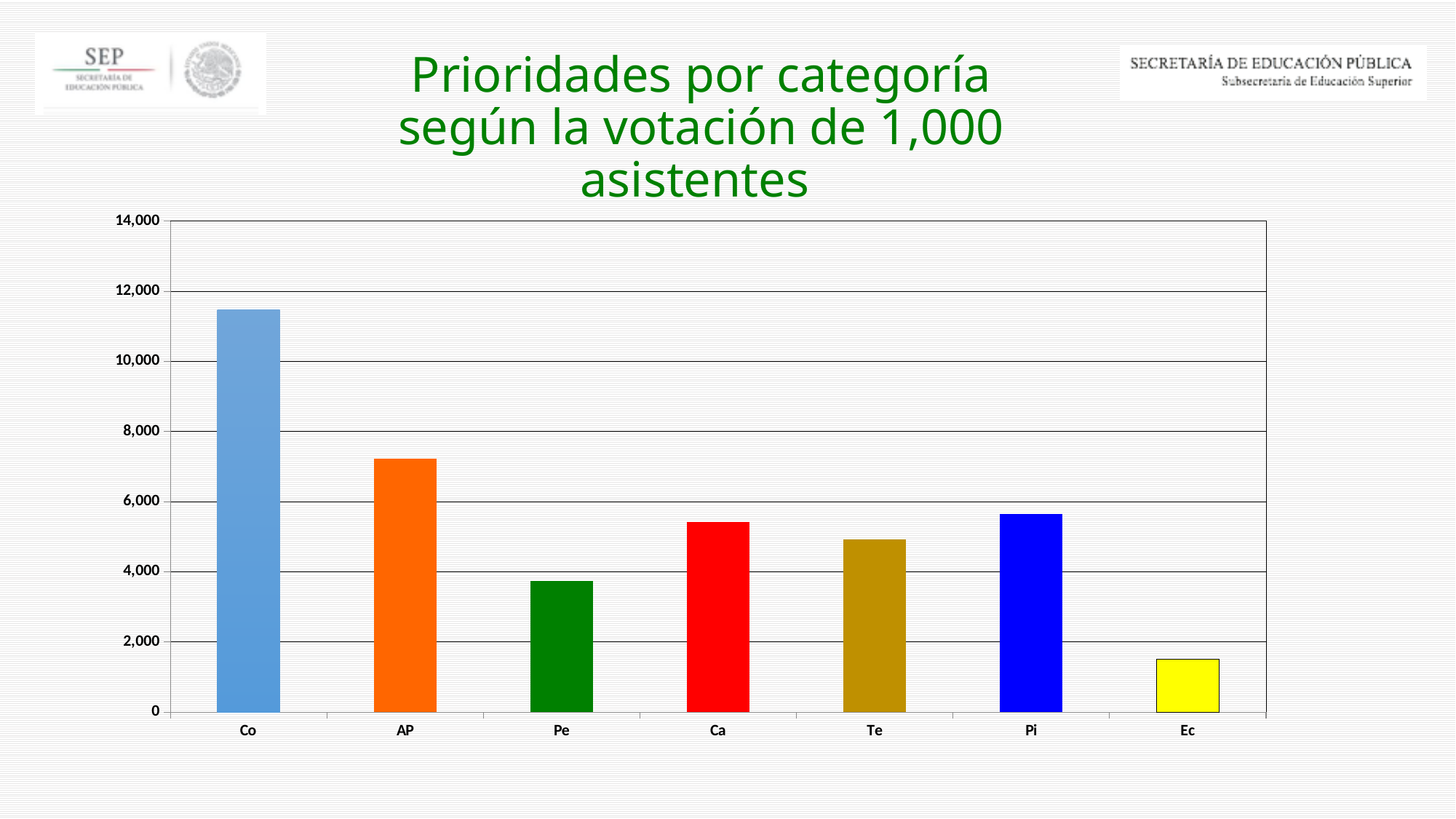
What is the title of the chart? Prioridades por categoría según la votación de 1,000 asistentes Which category has the highest value? Co Is the value for Te greater or less than 4,000? greater Is the value for AP greater or less than 8,000? less Which category has the lowest value? Ec Which is larger, the value for Co or the value for AP? Co How many categories are shown on the x axis? 7 Is the value for Ec greater or less than 2,000? less What kind of chart is shown on the slide? Bar chart Which is larger, the value for Pe or the value for Ca? Ca